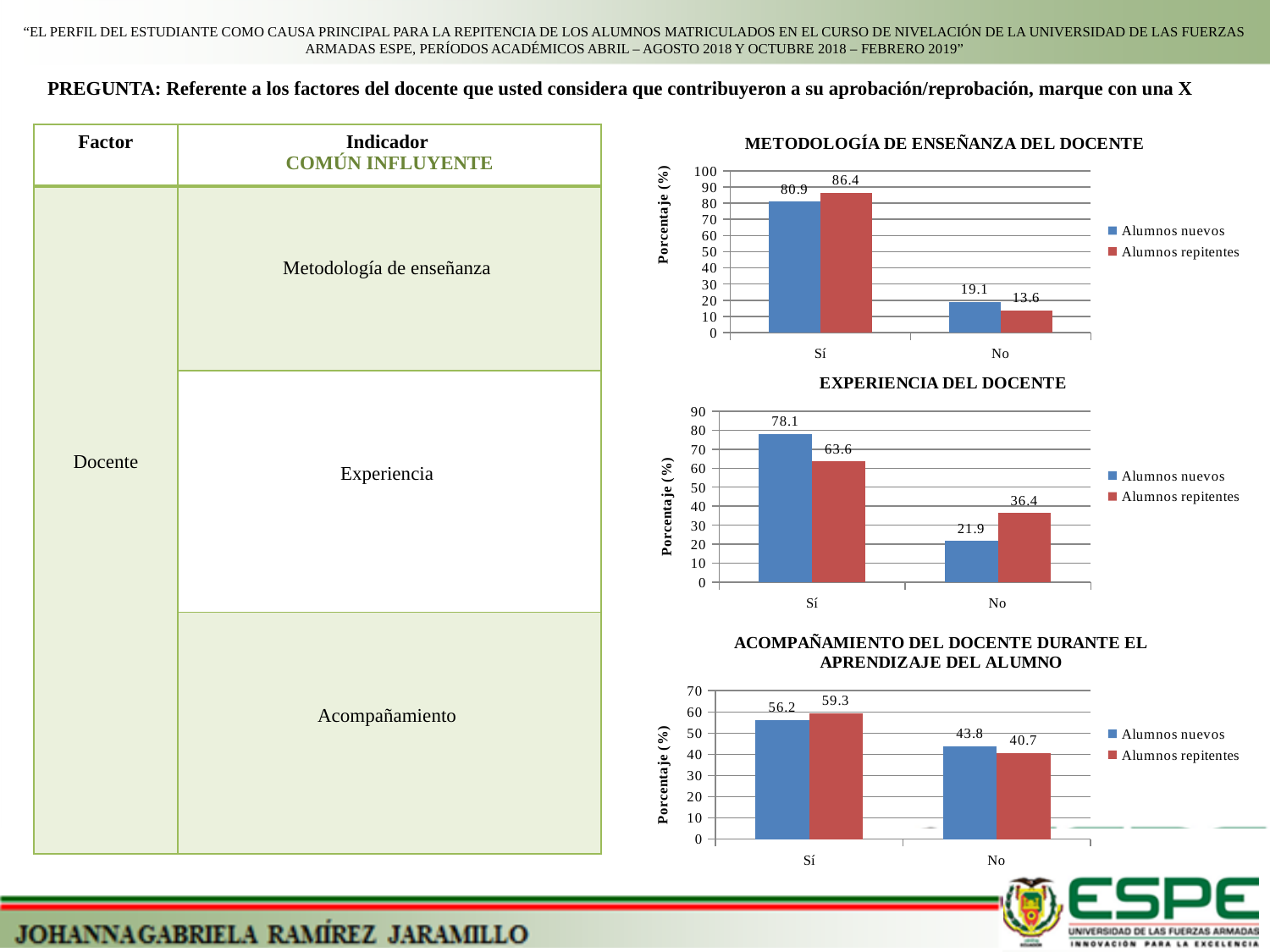
In the 'ACOMPAÑAMIENTO DEL DOCENTE DURANTE EL APRENDIZAJE DEL ALUMNO' chart, what is the difference between Alumnos repitentes and Alumnos nuevos in the Sí category? 3.1 What kind of chart is the 'METODOLOGÍA DE ENSEÑANZA DEL DOCENTE' chart? Bar chart How many series does the legend of the 'EXPERIENCIA DEL DOCENTE' chart list? 2 In the 'METODOLOGÍA DE ENSEÑANZA DEL DOCENTE' chart, what is the value for Alumnos repitentes in the Sí category? 86.4 In the 'EXPERIENCIA DEL DOCENTE' chart, what is the difference between Alumnos nuevos and Alumnos repitentes in the Sí category? 14.5 In the 'ACOMPAÑAMIENTO DEL DOCENTE DURANTE EL APRENDIZAJE DEL ALUMNO' chart, what is the value for Alumnos nuevos in the No category? 43.8 In the 'ACOMPAÑAMIENTO DEL DOCENTE DURANTE EL APRENDIZAJE DEL ALUMNO' chart, which series has the larger value in the Sí category? Alumnos repitentes In the 'METODOLOGÍA DE ENSEÑANZA DEL DOCENTE' chart, what is the difference between Alumnos repitentes and Alumnos nuevos in the Sí category? 5.5 In the 'EXPERIENCIA DEL DOCENTE' chart, what is the value for Alumnos repitentes in the No category? 36.4 In the 'METODOLOGÍA DE ENSEÑANZA DEL DOCENTE' chart, what is the value for Alumnos nuevos in the No category? 19.1 In the 'EXPERIENCIA DEL DOCENTE' chart, which series has the larger value in the No category? Alumnos repitentes In the 'EXPERIENCIA DEL DOCENTE' chart, what is the value for Alumnos nuevos in the Sí category? 78.1